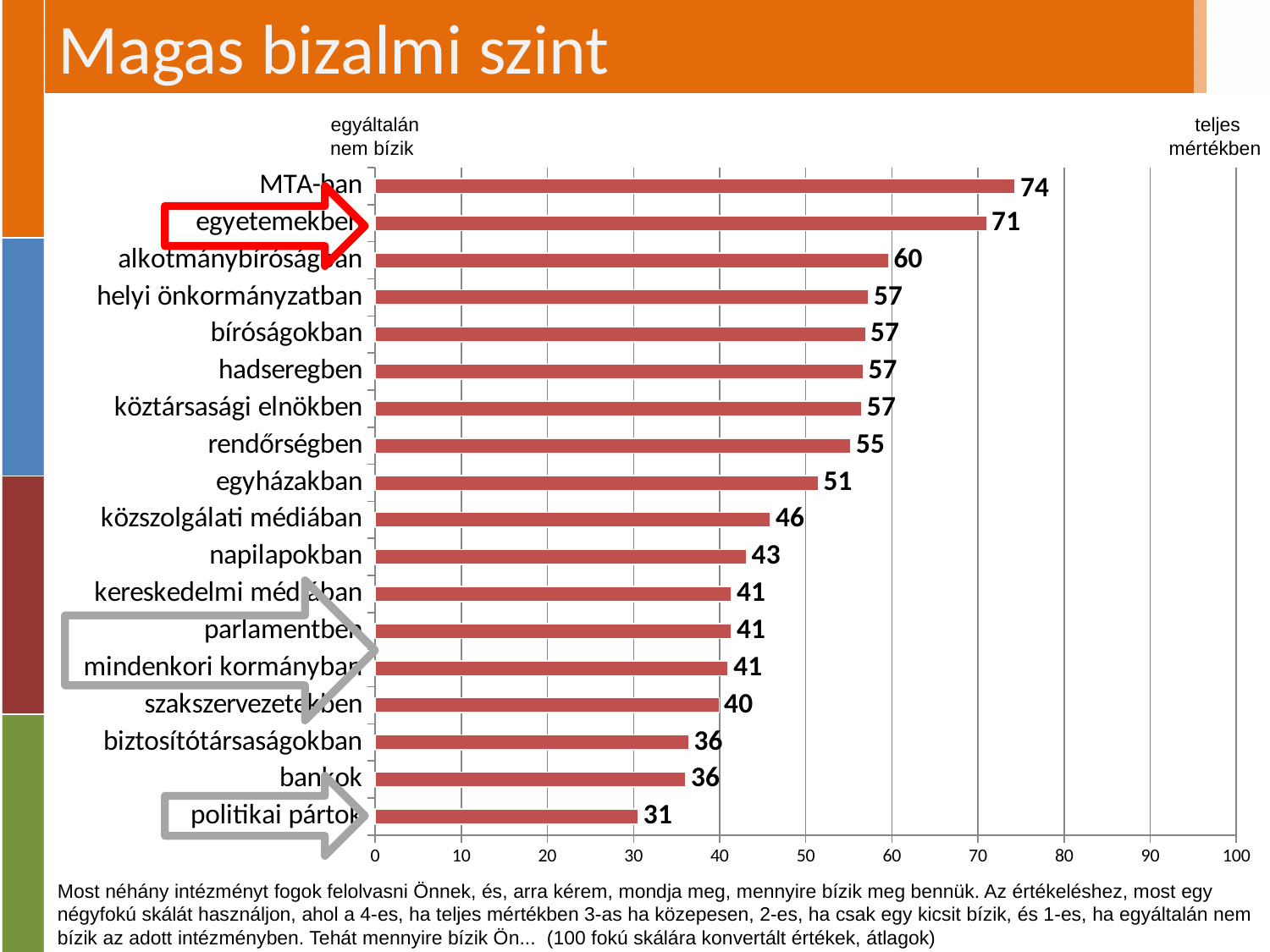
What is the title of the slide? Magas bizalmi szint What is the value for rendőrségben? 55 What kind of chart is shown on the slide? bar chart What is the difference between the values for egyetemekben and alkotmánybíróságban? 11 What is the difference between the values for MTA-ban and politikai pártok? 43 What is the value for egyetemekben? 71 What is the value for politikai pártok? 31 How many categories are shown in the chart? 18 Which category has the highest value? MTA-ban What is the value for MTA-ban? 74 Which is larger, the value for egyházakban or the value for napilapokban? egyházakban Which category has the lowest value? politikai pártok